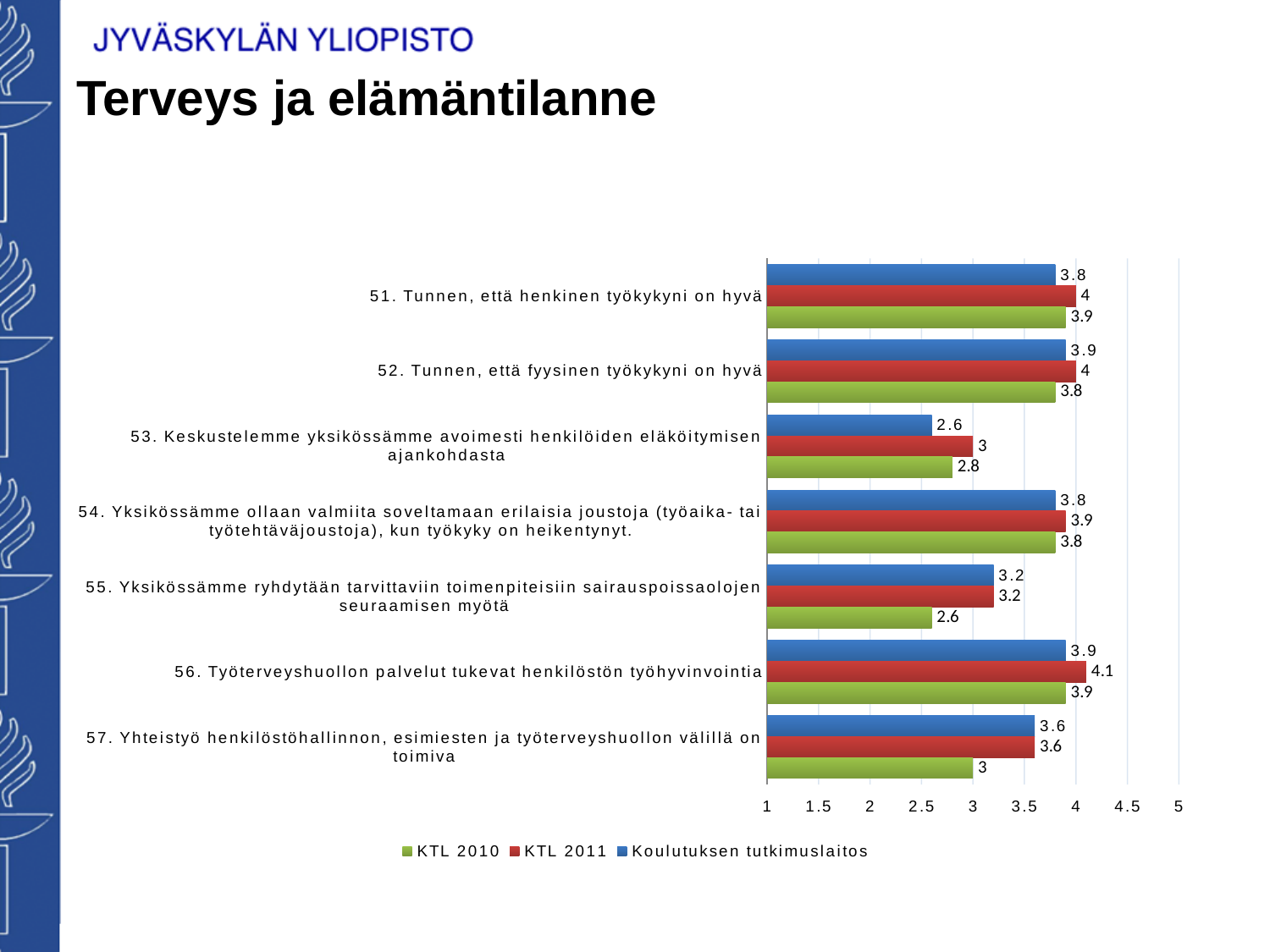
What is the KTL 2010 value for statement 57 (Yhteistyö henkilöstöhallinnon, esimiesten ja työterveyshuollon välillä on toimiva)? 3 How many series does the legend list? 3 What is the Koulutuksen tutkimuslaitos value for statement 53 (Keskustelemme yksikössämme avoimesti henkilöiden eläköitymisen ajankohdasta)? 2.6 For statement 55, which is larger: the KTL 2011 value or the KTL 2010 value? KTL 2011 What is the difference between the KTL 2011 and Koulutuksen tutkimuslaitos values for statement 53? 0.4 Which statement has the highest KTL 2011 value? 56. Työterveyshuollon palvelut tukevat henkilöstön työhyvinvointia What is the difference between the KTL 2011 and KTL 2010 values for statement 57? 0.6 What kind of chart is shown on the slide? bar chart Which statement has the lowest KTL 2010 value? 55. Yksikössämme ryhdytään tarvittaviin toimenpiteisiin sairauspoissaolojen seuraamisen myötä Which series is shown in green in the chart? KTL 2010 How many categories (statements) are plotted in the chart? 7 What is the KTL 2011 value for statement 56 (Työterveyshuollon palvelut tukevat henkilöstön työhyvinvointia)? 4.1